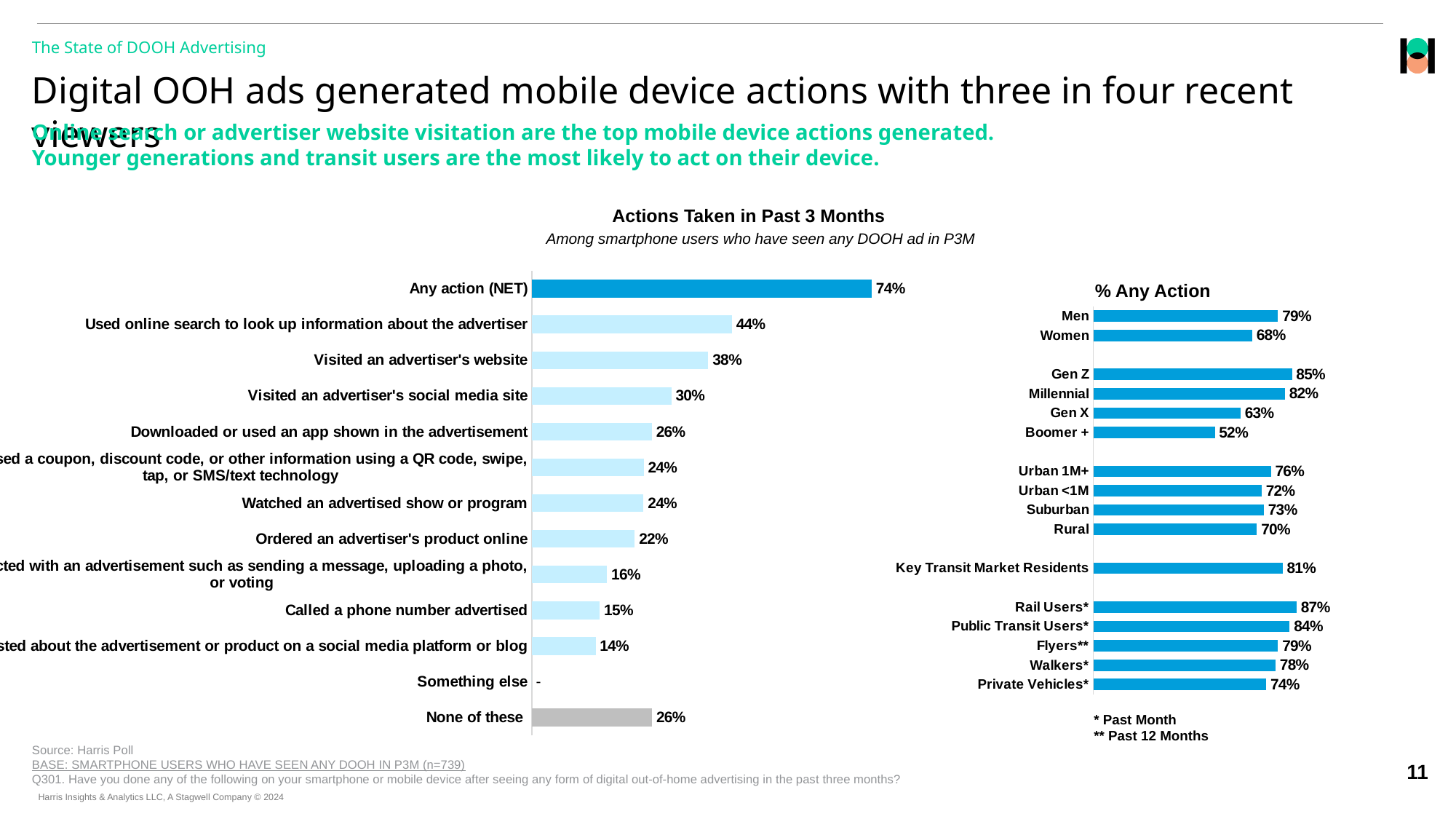
In the '% Any Action' chart, which group has the highest value? Rail Users* In the 'Actions Taken in Past 3 Months' chart, what is the value for 'None of these'? 26% In the '% Any Action' chart, which group has the lowest value? Boomer + In the 'Actions Taken in Past 3 Months' chart, what is the difference between 'Visited an advertiser's website' and 'Visited an advertiser's social media site'? 8% In the '% Any Action' chart, how many groups are plotted? 16 In the 'Actions Taken in Past 3 Months' chart, what is the value for 'Any action (NET)'? 74% What kind of chart is the '% Any Action' chart? Bar chart In the '% Any Action' chart, what is the value for Gen Z? 85% In the 'Actions Taken in Past 3 Months' chart, which is larger: 'Called a phone number advertised' or 'Ordered an advertiser's product online'? Ordered an advertiser's product online In the '% Any Action' chart, what is the difference between Men and Women? 11% In the 'Actions Taken in Past 3 Months' chart, what percentage used online search to look up information about the advertiser? 44% In the '% Any Action' chart, what is the value for Key Transit Market Residents? 81%